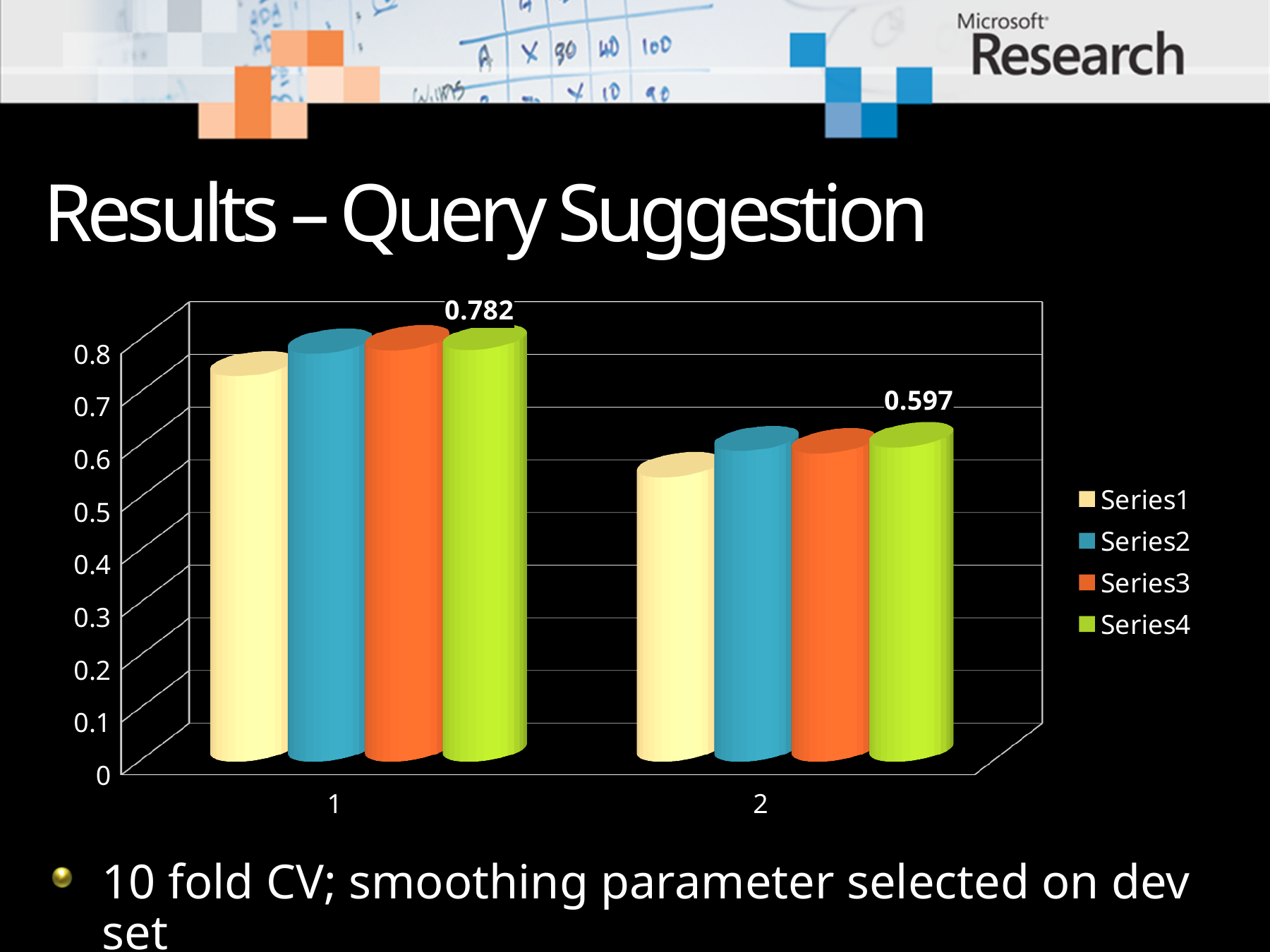
Which category has the larger Series4 value, 1 or 2? 1 What kind of chart is shown on the slide? Bar chart Is the value for Series1 in category 1 greater or less than 0.5? greater What is the value of Series4 for category 2? 0.597 What is the difference between the Series4 values for category 1 and category 2? 0.185 Which series has the lowest value in category 2? Series1 Do the values rise or fall from category 1 to category 2? Fall How many categories are shown on the x axis? 2 Which series has the lowest value in category 1? Series1 How many series does the legend list? 4 Is the value for Series1 in category 2 greater or less than 0.8? less What is the value of Series4 for category 1? 0.782